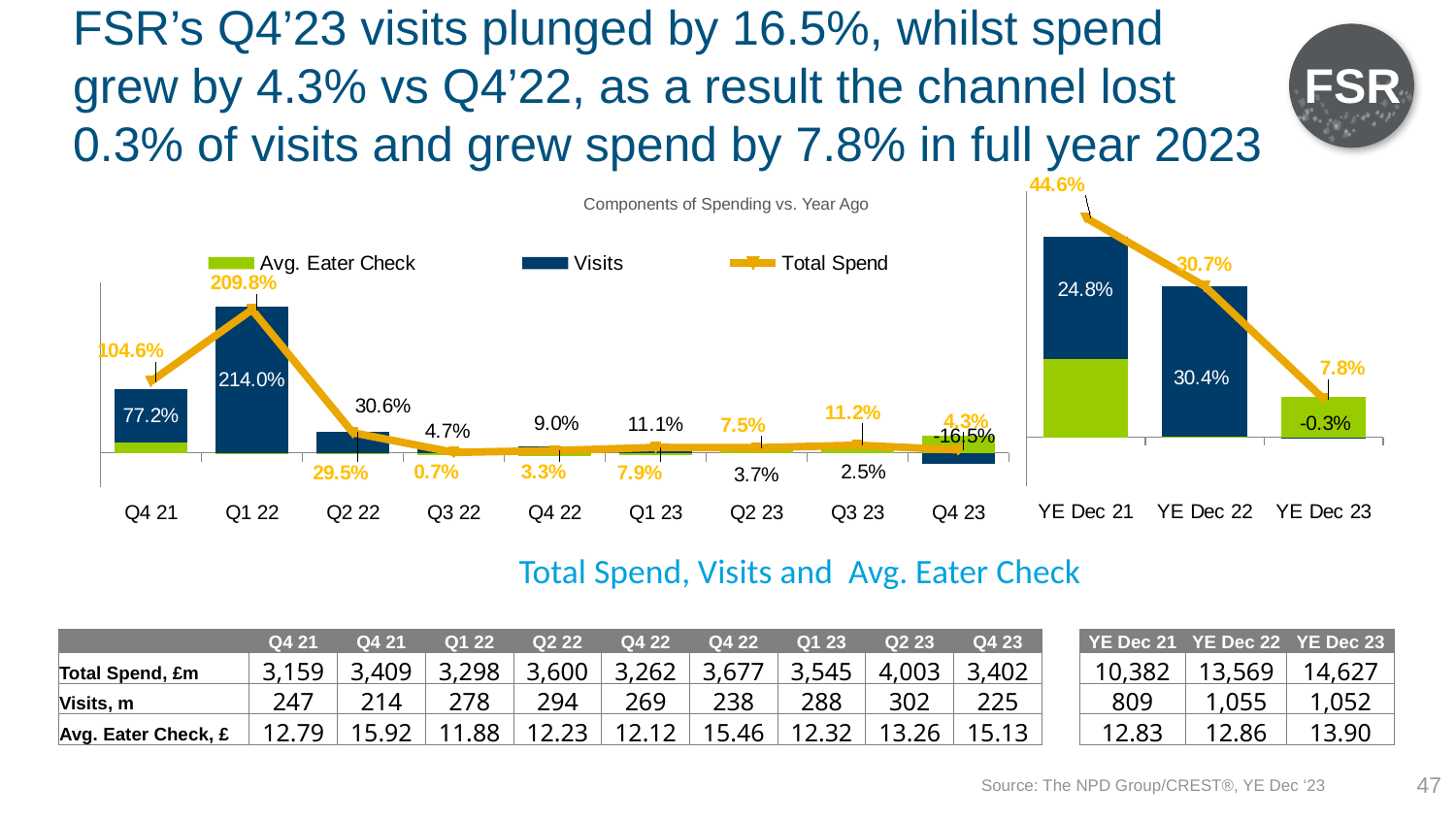
How many series does the legend of the left chart (Components of Spending vs. Year Ago) list? 3 In the left chart (Components of Spending vs. Year Ago), what is the Total Spend value for Q1 22? 209.8% In the left chart (Components of Spending vs. Year Ago), which quarter has the lowest Total Spend value? Q3 22 In the left chart (Components of Spending vs. Year Ago), what is the Total Spend value for Q4 23? 4.3% In the right chart (YE Dec 21 to YE Dec 23), does the Total Spend line rise or fall from YE Dec 21 to YE Dec 23? fall In the left chart (Components of Spending vs. Year Ago), what is the Visits value for Q4 23? -16.5% In the left chart (Components of Spending vs. Year Ago), which quarter has the larger Total Spend value, Q2 23 or Q3 23? Q3 23 In the left chart (Components of Spending vs. Year Ago), which quarter has the highest Total Spend value? Q1 22 How many quarters are shown on the x axis of the left chart (Components of Spending vs. Year Ago)? 9 In the right chart (YE Dec 21 to YE Dec 23), what is the Total Spend value for YE Dec 21? 44.6% In the left chart (Components of Spending vs. Year Ago), what is the difference between the Total Spend values for Q1 22 and Q4 21? 105.2 percentage points In the right chart (YE Dec 21 to YE Dec 23), what is the difference between the Total Spend values for YE Dec 22 and YE Dec 23? 22.9 percentage points